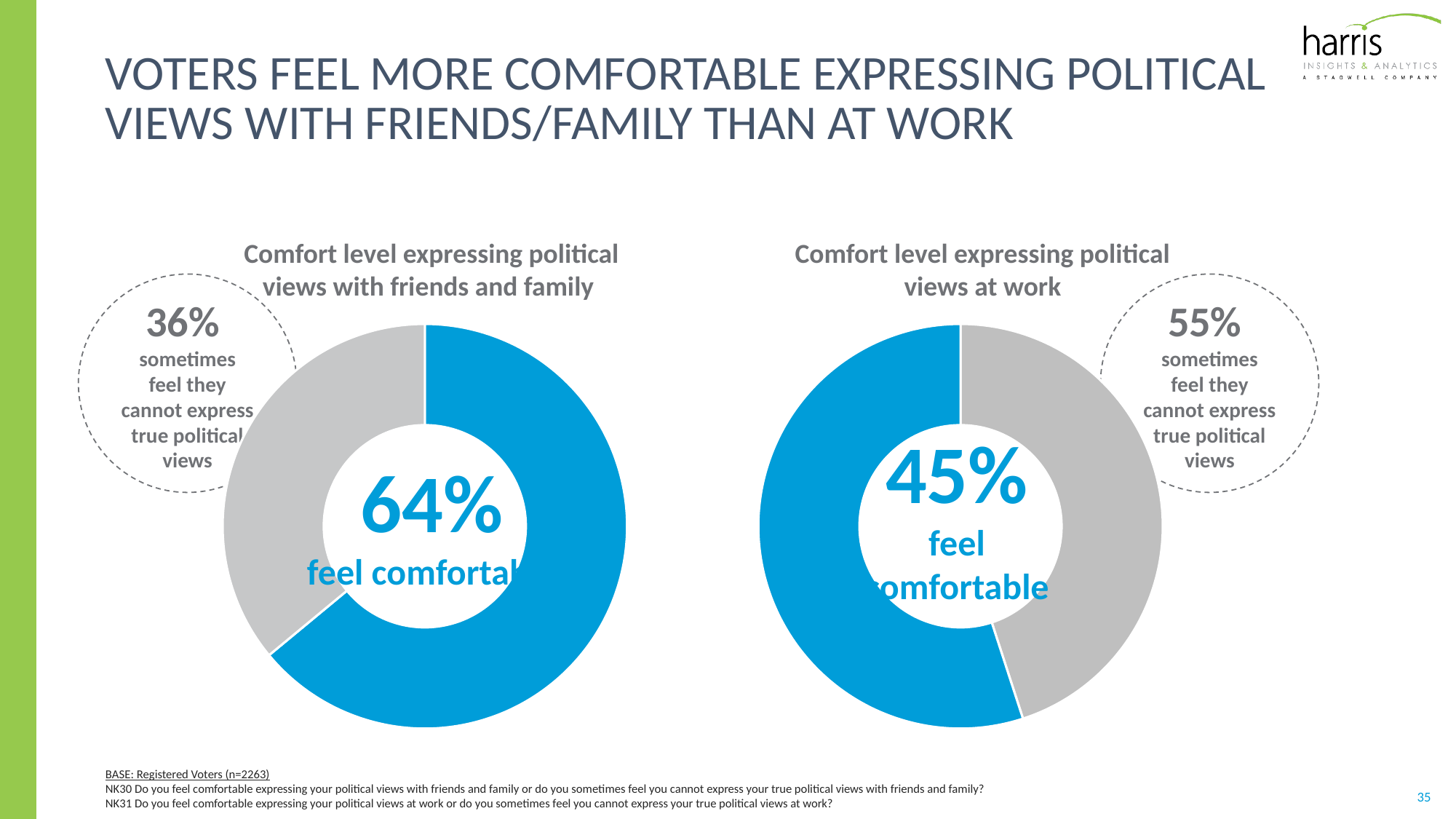
In the chart 'Comfort level expressing political views with friends and family', what percentage feel comfortable? 64% How many charts are shown on the slide? 2 In the chart 'Comfort level expressing political views with friends and family', what is the difference between the two segments? 28 percentage points In the chart 'Comfort level expressing political views at work', what percentage sometimes feel they cannot express true political views? 55% In the chart 'Comfort level expressing political views with friends and family', which segment is larger: feel comfortable or sometimes feel they cannot express true political views? Feel comfortable In the chart 'Comfort level expressing political views with friends and family', what colour is the 'feel comfortable' segment? Blue How many segments does the chart 'Comfort level expressing political views at work' have? 2 What is the difference between the share who feel comfortable with friends and family and the share who feel comfortable at work? 19 percentage points In the chart 'Comfort level expressing political views with friends and family', what percentage sometimes feel they cannot express true political views? 36% What kind of chart is used for 'Comfort level expressing political views at work'? Doughnut chart In the chart 'Comfort level expressing political views at work', which segment is larger: feel comfortable or sometimes feel they cannot express true political views? Sometimes feel they cannot express true political views In the chart 'Comfort level expressing political views at work', what percentage feel comfortable? 45%